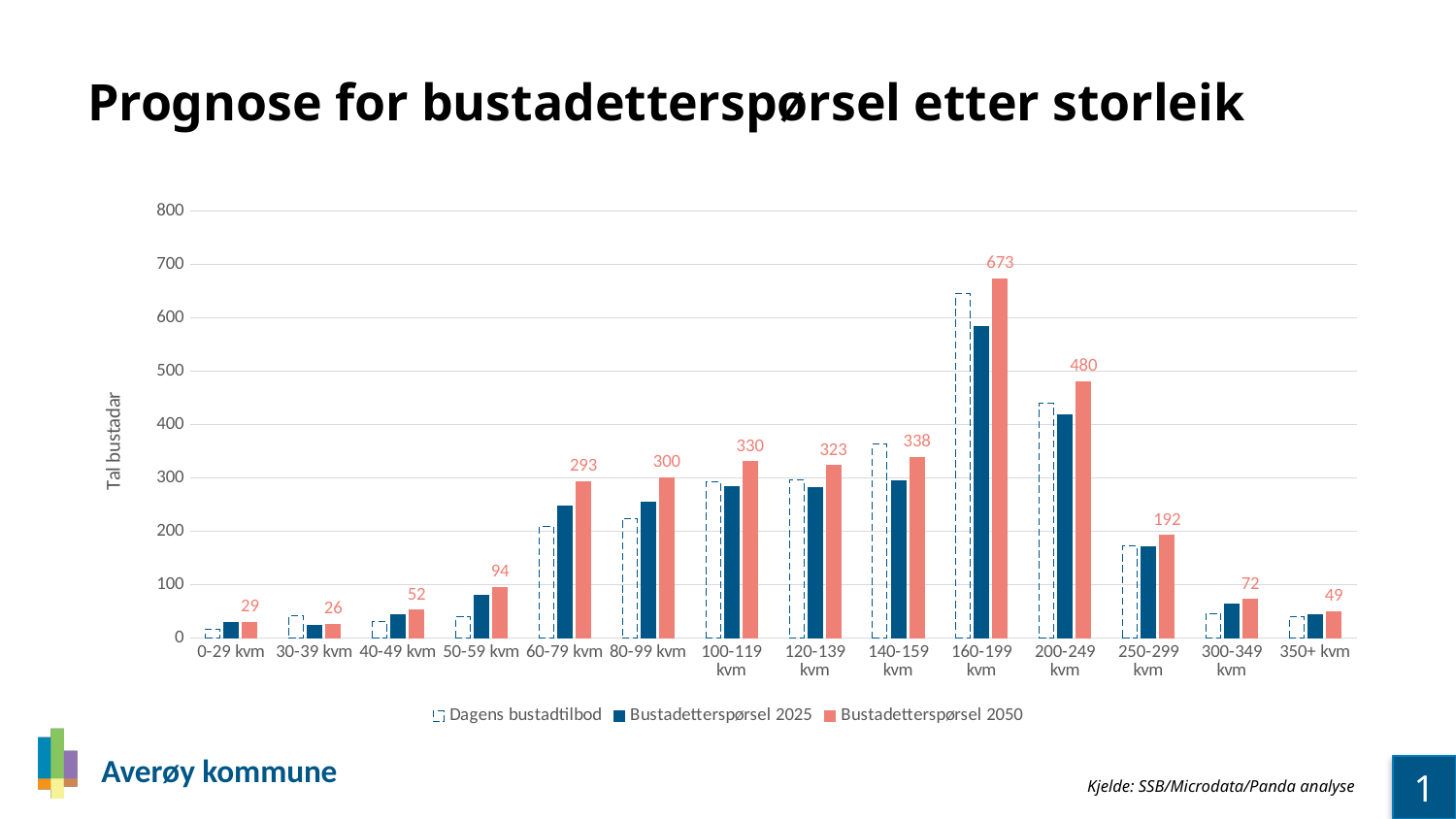
How many series does the legend list? 3 Which size category has the lowest value for Bustadetterspørsel 2050? 30-39 kvm Is the value for Bustadetterspørsel 2025 in the 160-199 kvm category greater or less than 500? greater What is the value for Bustadetterspørsel 2050 in the 160-199 kvm category? 673 Is the value for Dagens bustadtilbod in the 60-79 kvm category greater or less than 300? less How many size categories are shown on the x axis? 14 What is the value for Bustadetterspørsel 2050 in the 300-349 kvm category? 72 What is the difference between the Bustadetterspørsel 2050 values for 160-199 kvm and 200-249 kvm? 193 What is the value for Bustadetterspørsel 2050 in the 60-79 kvm category? 293 Which size category has the highest value for Bustadetterspørsel 2050? 160-199 kvm Which is larger for Bustadetterspørsel 2050: 100-119 kvm or 120-139 kvm? 100-119 kvm What kind of chart is shown on the slide? Bar chart